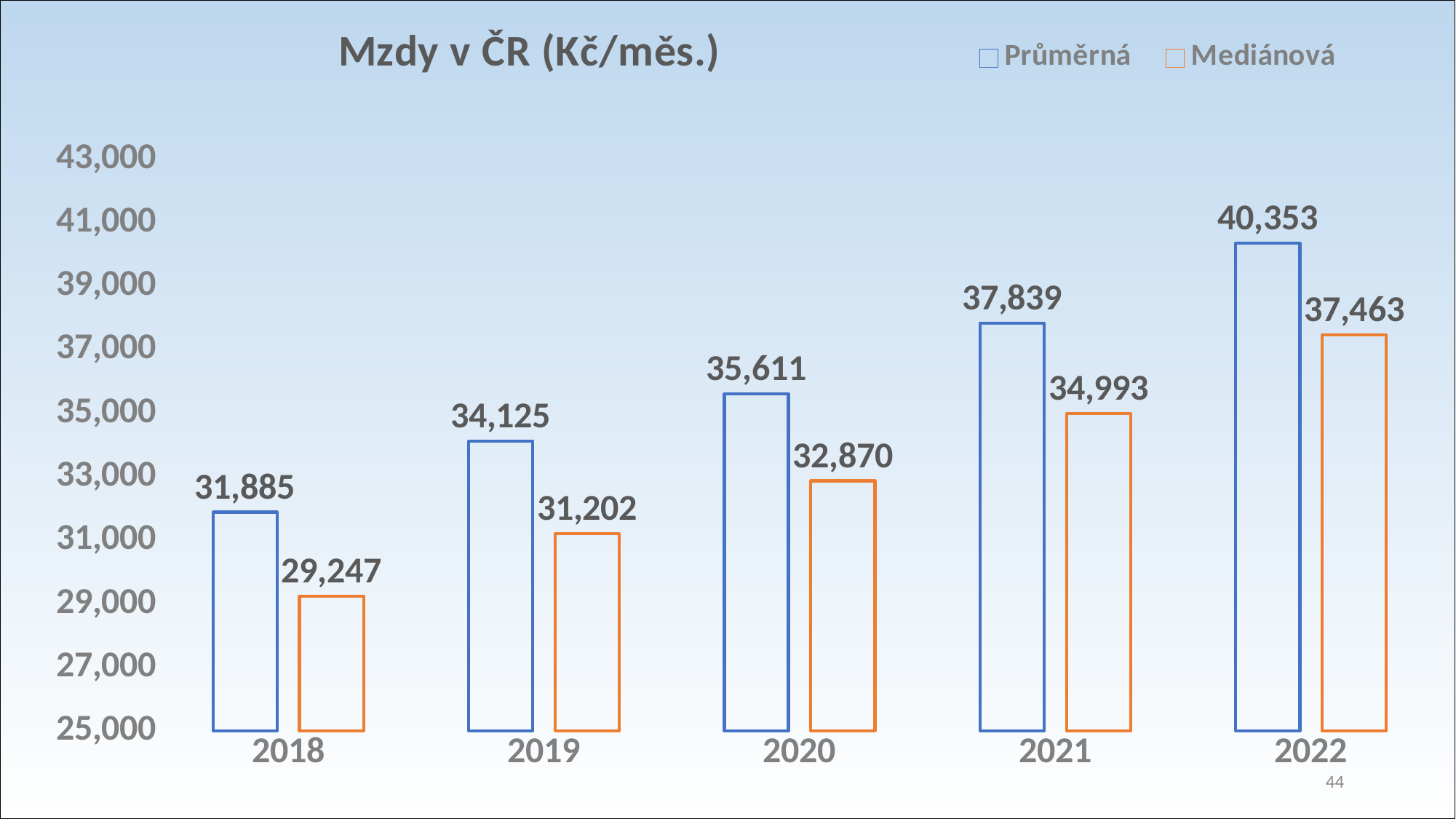
What is the Průměrná value for 2020? 35,611 What is the difference between the Průměrná and Mediánová values for 2021? 2,846 What is the Mediánová value for 2022? 37,463 How many years are shown on the x axis? 5 What is the Mediánová value for 2018? 29,247 What kind of chart is shown on the slide? Bar chart Do the Mediánová values rise or fall from 2018 to 2022? Rise What is the difference between the Průměrná values for 2022 and 2018? 8,468 How many series does the legend list? 2 Which is larger, the Mediánová value for 2021 or the Průměrná value for 2019? Mediánová value for 2021 Which year has the highest Průměrná value? 2022 Which year has the lowest Mediánová value? 2018